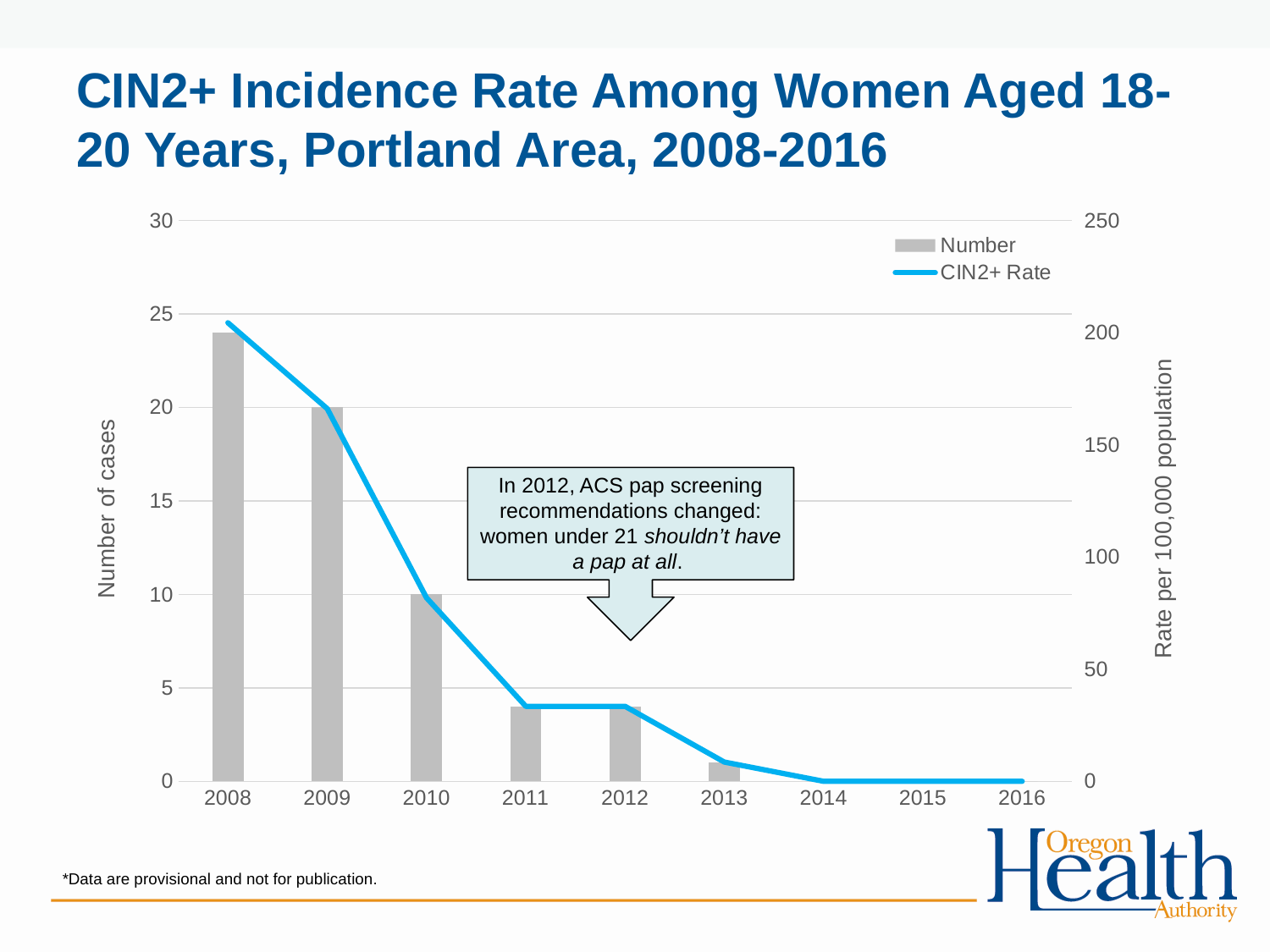
Which year has the larger Number of cases, 2009 or 2010? 2009 Is the Number of cases for 2011 greater or less than 5? less What is the Number of cases for 2010? 10 Is the Number of cases for 2008 greater or less than 20? greater Is the CIN2+ Rate for 2008 greater or less than 150? greater Which year has the highest Number of cases? 2008 How many years are shown along the x axis? 9 How many series does the legend list? 2 What kind of chart is shown on the slide? A bar chart combined with a line Does the CIN2+ Rate rise or fall from 2008 to 2016? fall What is the Number of cases for 2009? 20 What is the difference in Number of cases between 2009 and 2010? 10